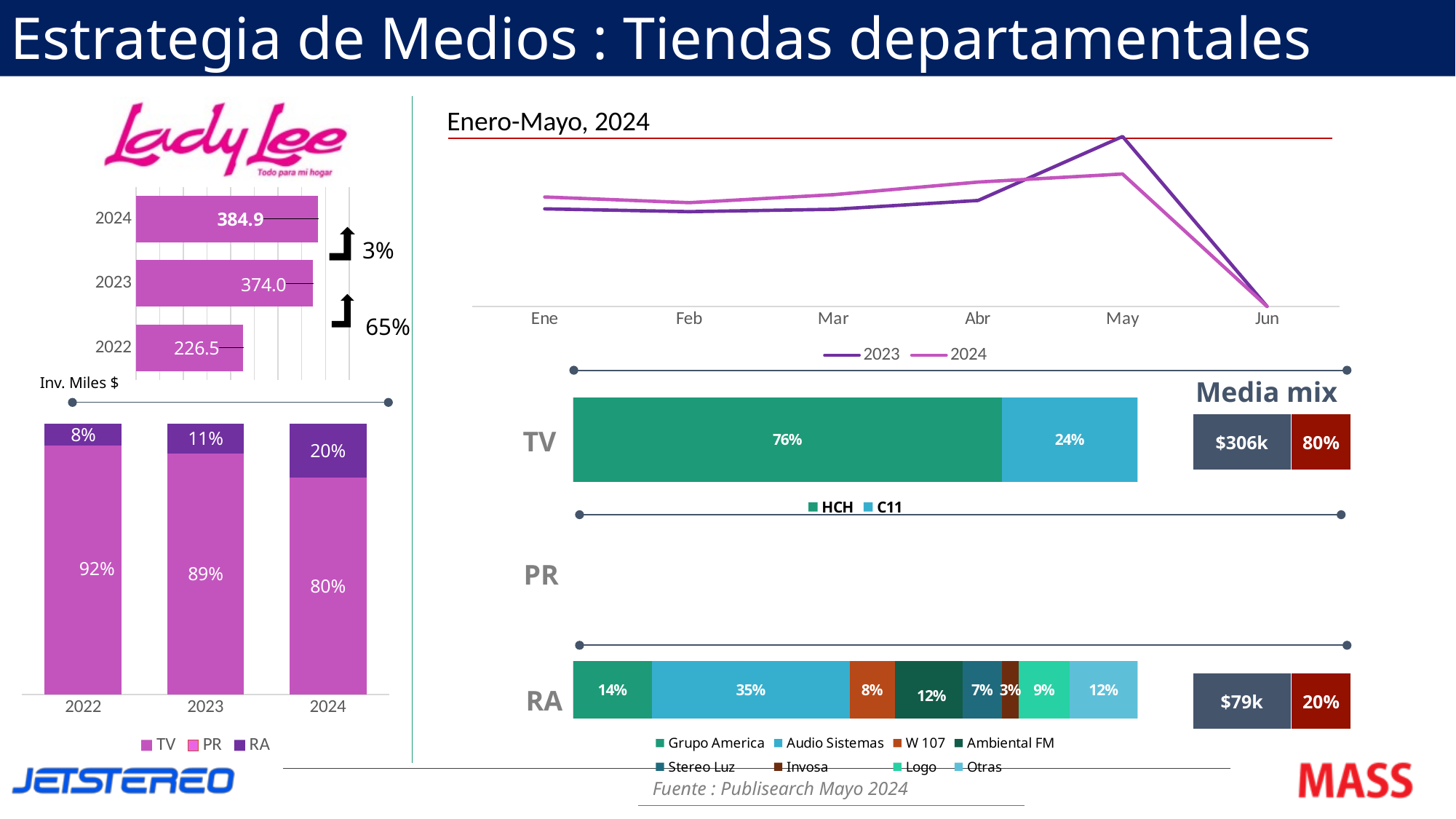
In the stacked bar chart at the bottom left, what share does TV have in 2023? 89% In the 'Inv. Miles $' horizontal bar chart at the top left, what is the difference between the 2023 and 2022 values? 147.5 In the stacked bar chart at the bottom left, does the RA share rise or fall from 2022 to 2024? rise In the 'Inv. Miles $' horizontal bar chart at the top left, which year has the lowest value? 2022 In the 'Enero-Mayo, 2024' line chart, how many months are shown on the x axis? 6 How many series does the legend of the stacked bar chart at the bottom left list? 3 In the stacked bar chart at the bottom left, what share does RA have in 2024? 20% In the 'Enero-Mayo, 2024' line chart, which series does the legend list besides 2024? 2023 In the RA stacked bar, what is the difference between the Audio Sistemas and Grupo America shares? 21% In the 'Inv. Miles $' horizontal bar chart at the top left, what is the value for 2024? 384.9 In the TV stacked bar, what share does HCH have? 76% In the RA stacked bar, which station has the largest share? Audio Sistemas